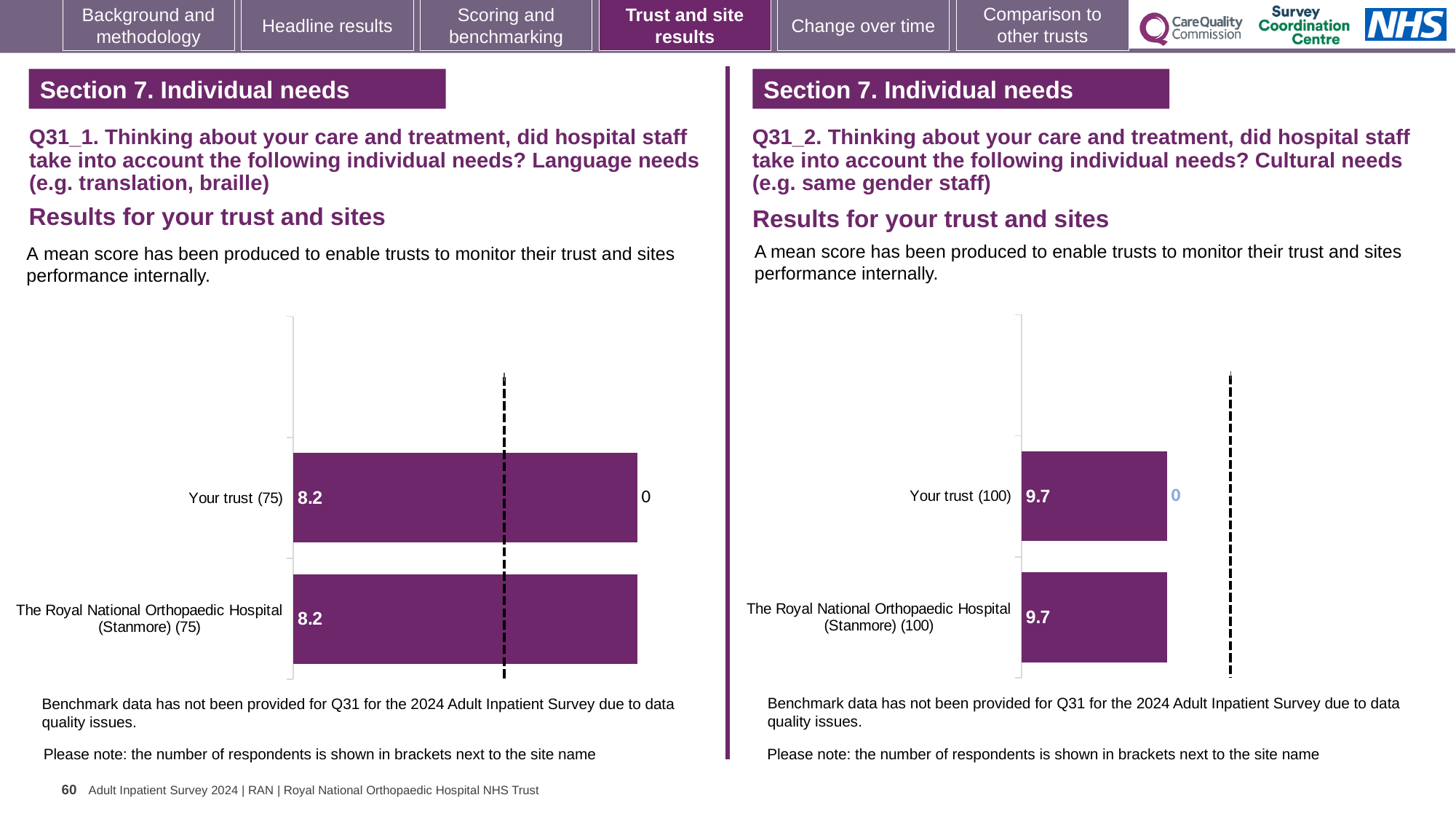
In the Q31_2 Cultural needs chart on the right, what is the mean score for The Royal National Orthopaedic Hospital (Stanmore)? 9.7 In the Q31_1 Language needs chart on the left, what is the difference between the Your trust score and the Stanmore site score? 0 In the Q31_2 Cultural needs chart on the right, how many categories are shown? 2 What is the difference between the Your trust score in the Q31_2 Cultural needs chart (right) and the Your trust score in the Q31_1 Language needs chart (left)? 1.5 What type of chart is used in the Q31_1 Language needs chart on the left? Bar chart In the Q31_1 Language needs chart on the left, how many bars are plotted? 2 In the Q31_2 Cultural needs chart on the right, how many respondents are shown in brackets for The Royal National Orthopaedic Hospital (Stanmore)? 100 In the Q31_1 Language needs chart on the left, what is the mean score for The Royal National Orthopaedic Hospital (Stanmore)? 8.2 In the Q31_1 Language needs chart on the left, how many respondents are shown in brackets for Your trust? 75 In the Q31_1 Language needs chart on the left, what is the mean score for Your trust? 8.2 Is the Your trust score higher in the Q31_1 Language needs chart on the left or in the Q31_2 Cultural needs chart on the right? Q31_2 Cultural needs chart In the Q31_2 Cultural needs chart on the right, what is the mean score for Your trust? 9.7